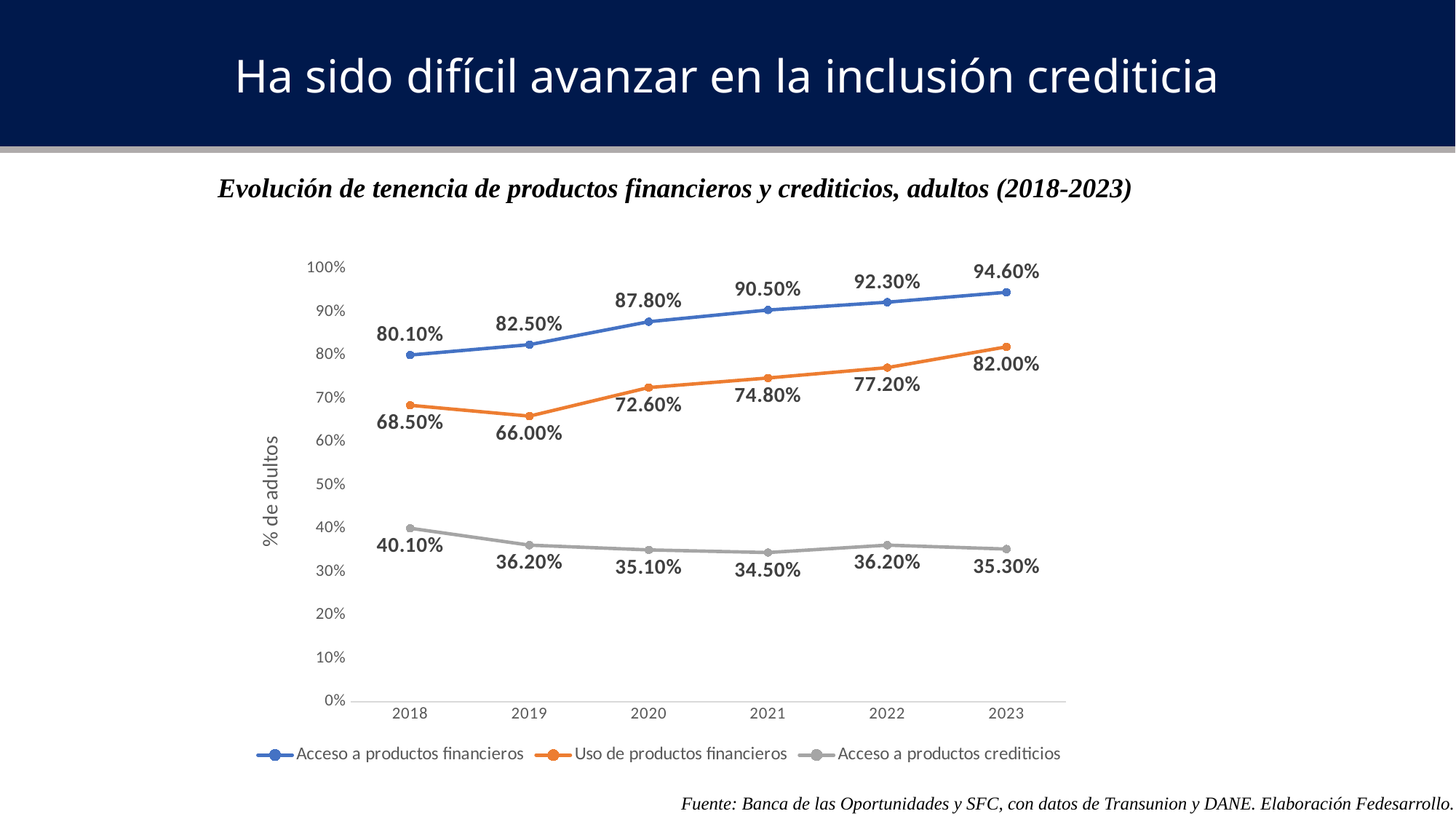
How many series does the legend list? 3 Is the value for 'Acceso a productos crediticios' in 2022 greater or less than 40%? less In which year is the 'Acceso a productos crediticios' series lowest? 2021 What is the difference between 'Acceso a productos financieros' and 'Uso de productos financieros' in 2023? 12.60% Which is larger in 2020: 'Acceso a productos financieros' or 'Acceso a productos crediticios'? Acceso a productos financieros How many years are shown on the x axis? 6 Does the 'Acceso a productos financieros' series rise or fall from 2018 to 2023? Rise In which year is the 'Uso de productos financieros' series highest? 2023 What value does the 'Acceso a productos financieros' series show for 2023? 94.60% What value does the 'Uso de productos financieros' series show for 2019? 66.00% What kind of chart is shown on the slide? Line chart What value does the 'Acceso a productos crediticios' series show for 2018? 40.10%